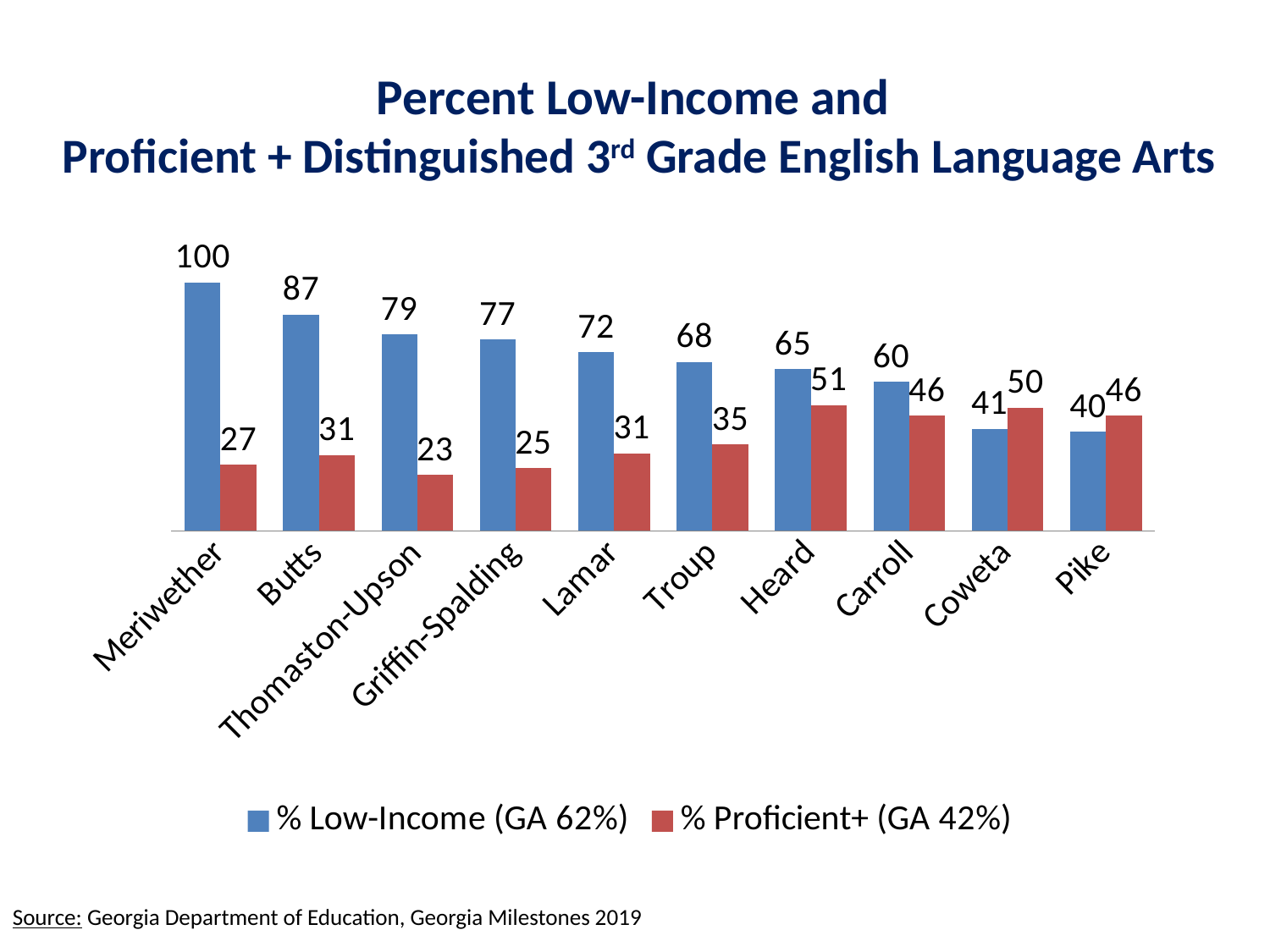
What is the difference between the % Low-Income and % Proficient+ values for Butts? 56 Which county has the highest % Low-Income value? Meriwether How many series does the legend list? 2 What is the % Proficient+ value for Lamar? 31 What kind of chart is shown on the slide? Bar chart What is the % Proficient+ value for Heard? 51 Do the % Low-Income values rise or fall from Meriwether to Pike? Fall How many counties are shown on the chart? 10 What is the % Low-Income value for Meriwether? 100 Which is larger for Coweta: % Low-Income or % Proficient+? % Proficient+ Which county has the lowest % Proficient+ value? Thomaston-Upson What Georgia statewide value is given in the legend for % Low-Income? 62%